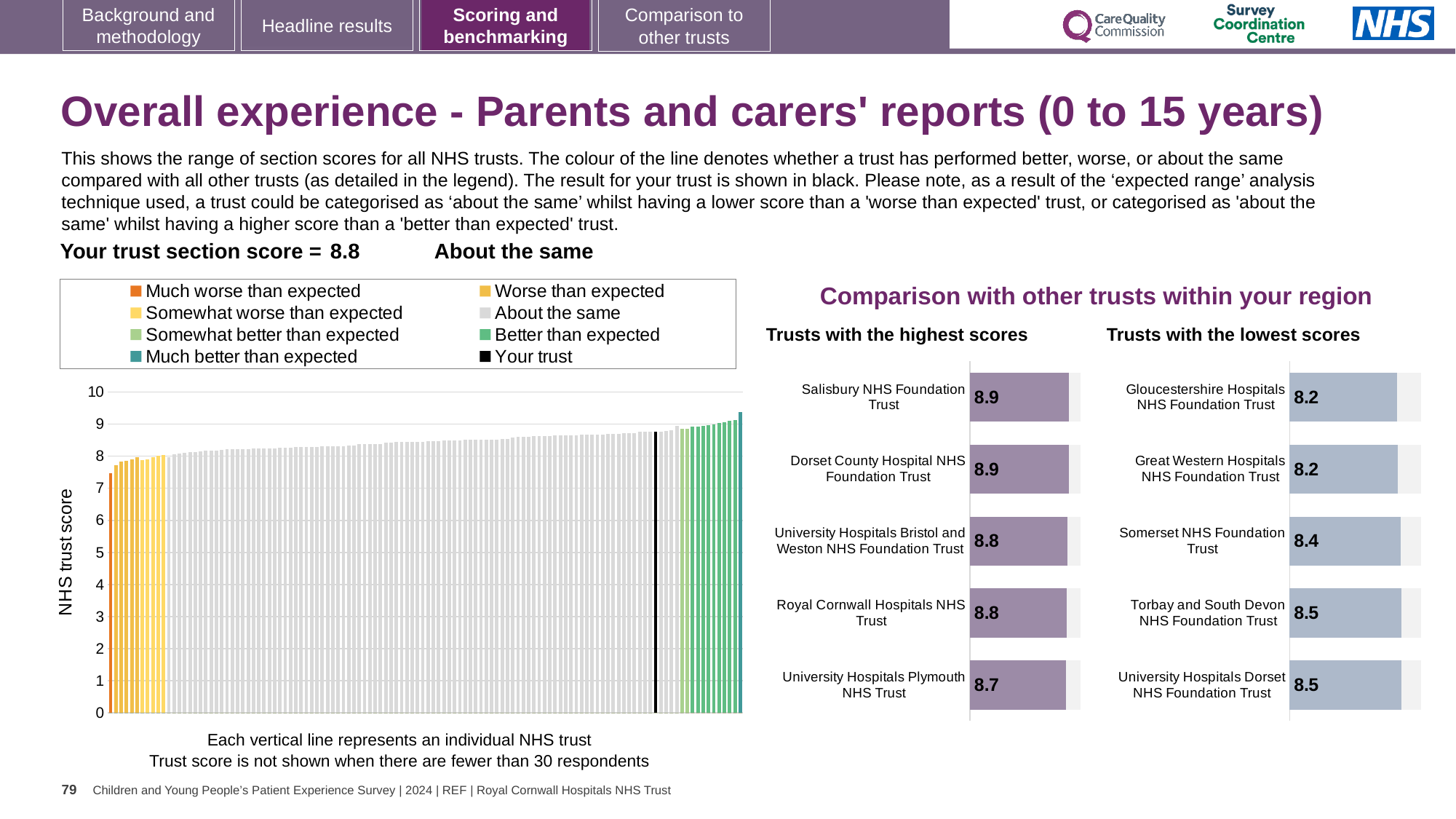
How many entries does the legend above the large chart on the left list? 8 In the 'Trusts with the lowest scores' chart, which trust has the lowest score among those listed, Gloucestershire Hospitals NHS Foundation Trust or University Hospitals Dorset NHS Foundation Trust? Gloucestershire Hospitals NHS Foundation Trust In the 'Trusts with the lowest scores' chart, what is the difference between the scores of Somerset NHS Foundation Trust and Great Western Hospitals NHS Foundation Trust? 0.2 What kind of chart is the large chart on the left showing NHS trust scores? Bar chart In the 'Trusts with the highest scores' chart, what is the score for Salisbury NHS Foundation Trust? 8.9 In the large chart on the left, is the value for the black bar (Your trust) greater or less than 8? greater In the 'Trusts with the lowest scores' chart, what is the score for Somerset NHS Foundation Trust? 8.4 In the 'Trusts with the highest scores' chart, what is the difference between the scores of Salisbury NHS Foundation Trust and University Hospitals Plymouth NHS Trust? 0.2 In the 'Trusts with the lowest scores' chart, which has the higher score: Somerset NHS Foundation Trust or Torbay and South Devon NHS Foundation Trust? Torbay and South Devon NHS Foundation Trust In the 'Trusts with the highest scores' chart, what is the score for University Hospitals Plymouth NHS Trust? 8.7 In the 'Trusts with the lowest scores' chart, what is the score for Gloucestershire Hospitals NHS Foundation Trust? 8.2 In the 'Trusts with the highest scores' chart, how many trusts are listed? 5